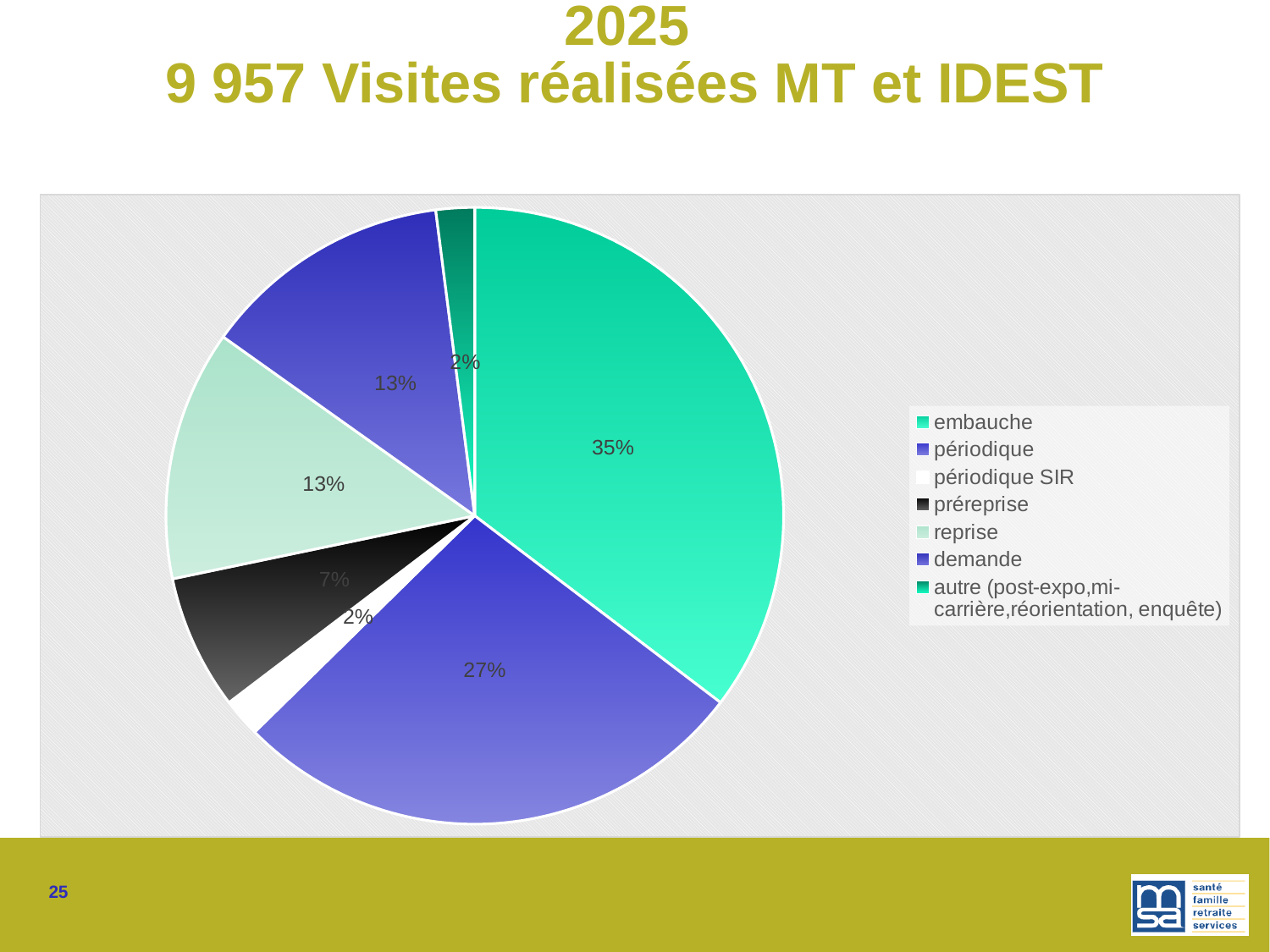
Which is larger, the slice for préreprise or the slice for reprise? reprise What is the value shown for préreprise? 7% What share of the pie does the embauche slice represent? 35% How many categories does the legend list? 7 What total number of visits is stated in the slide title? 9 957 What is the value shown for reprise? 13% What is the difference in percentage points between périodique and demande? 14 Which category has the largest slice of the pie? embauche What kind of chart is shown on the slide? pie chart What is the value shown for périodique SIR? 2% What is the difference in percentage points between embauche and périodique? 8 What is the value shown for périodique? 27%